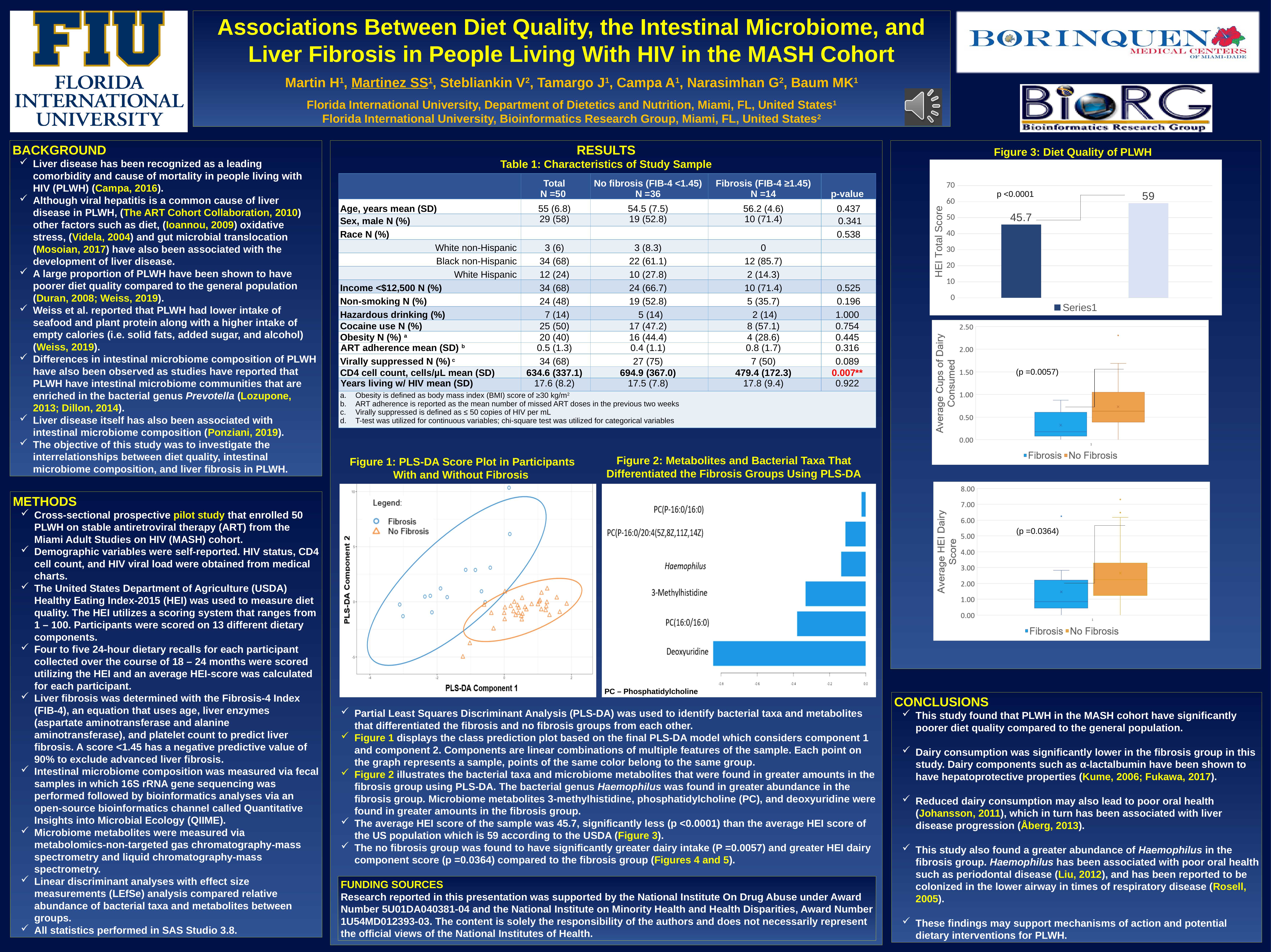
In Figure 2, how many categories are plotted? 6 In Figure 2, is the value for Deoxyuridine greater or less than -0.6? less In Figure 3: Diet Quality of PLWH, what is the value of the left bar? 45.7 In Figure 3: Diet Quality of PLWH, how many bars are plotted? 2 What kind of chart is Figure 2: Metabolites and Bacterial Taxa That Differentiated the Fibrosis Groups Using PLS-DA? bar chart In Figure 3: Diet Quality of PLWH, what is the y-axis title? HEI Total Score In Figure 3: Diet Quality of PLWH, what is the value of the right bar? 59 In the box plot of Average Cups of Dairy Consumed, how many groups does the legend list? 2 In Figure 3: Diet Quality of PLWH, which bar is taller, the left or the right? right In Figure 2, which category has the longest bar? Deoxyuridine In Figure 2, which category has the shortest bar? PC(P-16:0/16:0) In Figure 3: Diet Quality of PLWH, what is the difference between the two bars? 13.3